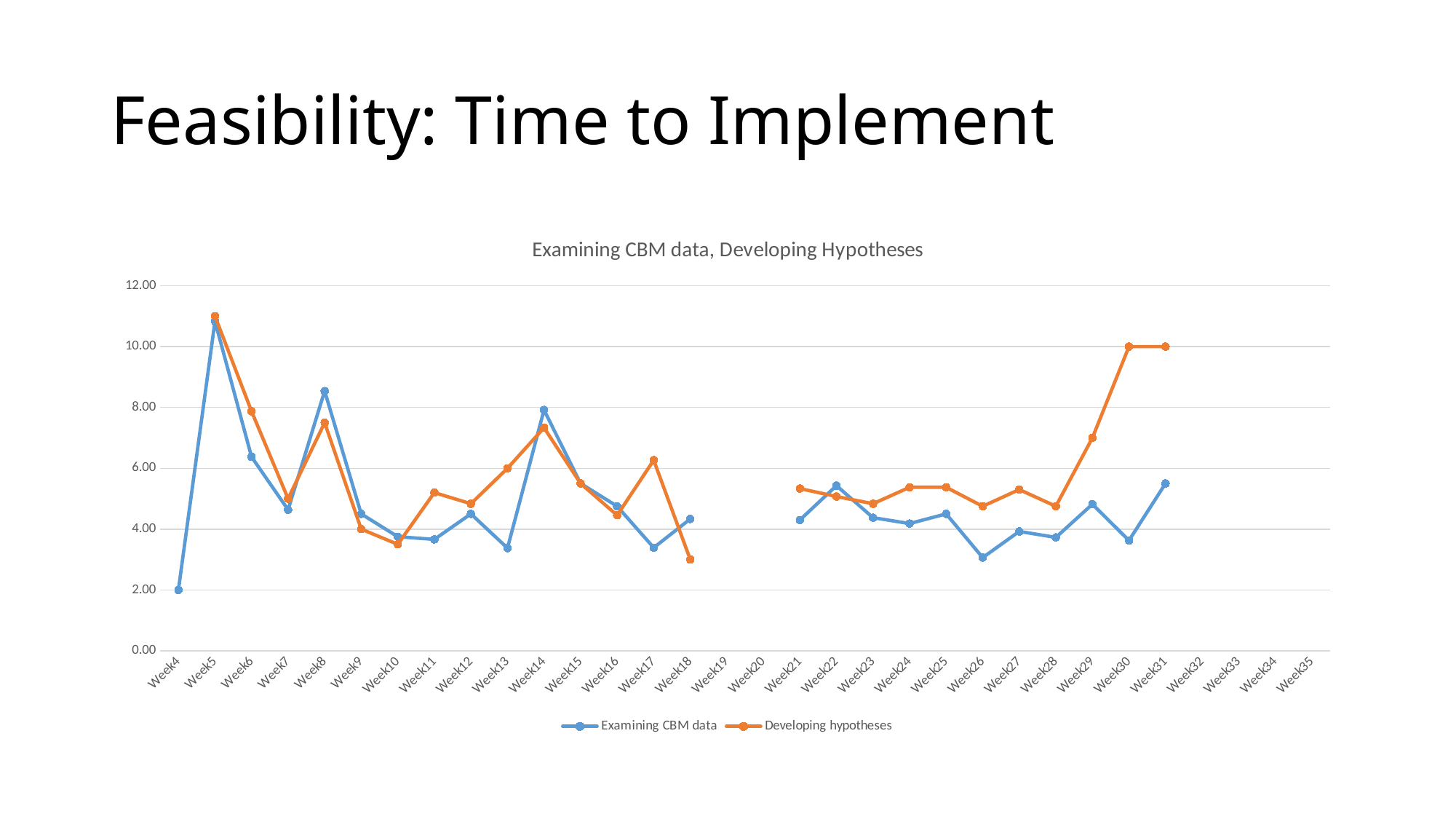
Is the value for Examining CBM data at Week26 greater or less than 4.00? less Is the value for Examining CBM data at Week8 greater or less than 8.00? greater What type of chart is shown on the slide? Line chart Does the Developing hypotheses series rise or fall from Week28 to Week30? Rise At which week is the Examining CBM data series lowest? Week4 At Week29, which series has the larger value, Examining CBM data or Developing hypotheses? Developing hypotheses At which week is the Examining CBM data series highest? Week5 What is the title of the chart? Examining CBM data, Developing Hypotheses How many series does the legend list? 2 What is the value for Developing hypotheses at Week31? 10.00 What is the value for Developing hypotheses at Week30? 10.00 What is the value for Examining CBM data at Week4? 2.00